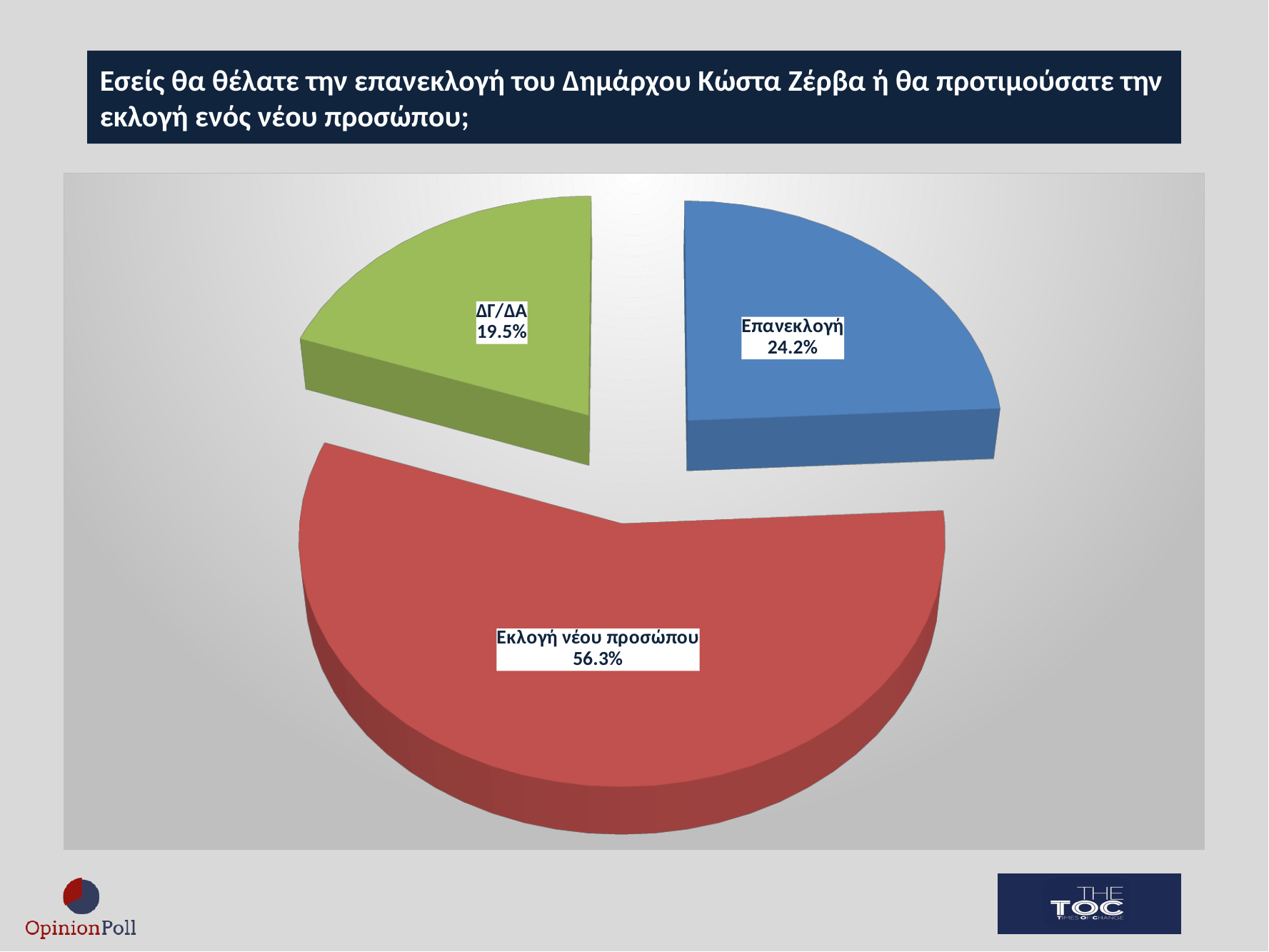
What percentage of respondents chose 'Εκλογή νέου προσώπου'? 56.3% Which is larger: the share for 'Επανεκλογή' or the share for 'ΔΓ/ΔΑ'? Επανεκλογή What percentage of respondents answered 'ΔΓ/ΔΑ'? 19.5% What is the difference in percentage points between 'Επανεκλογή' and 'ΔΓ/ΔΑ'? 4.7 What is the difference in percentage points between 'Εκλογή νέου προσώπου' and 'Επανεκλογή'? 32.1 What colour is the slice for 'Επανεκλογή'? Blue Which response has the largest share of the pie? Εκλογή νέου προσώπου What colour is the slice for 'Εκλογή νέου προσώπου'? Red How many slices does the pie chart have? 3 What percentage of respondents chose 'Επανεκλογή'? 24.2% What kind of chart is shown on the slide? Pie chart Which response has the smallest share of the pie? ΔΓ/ΔΑ